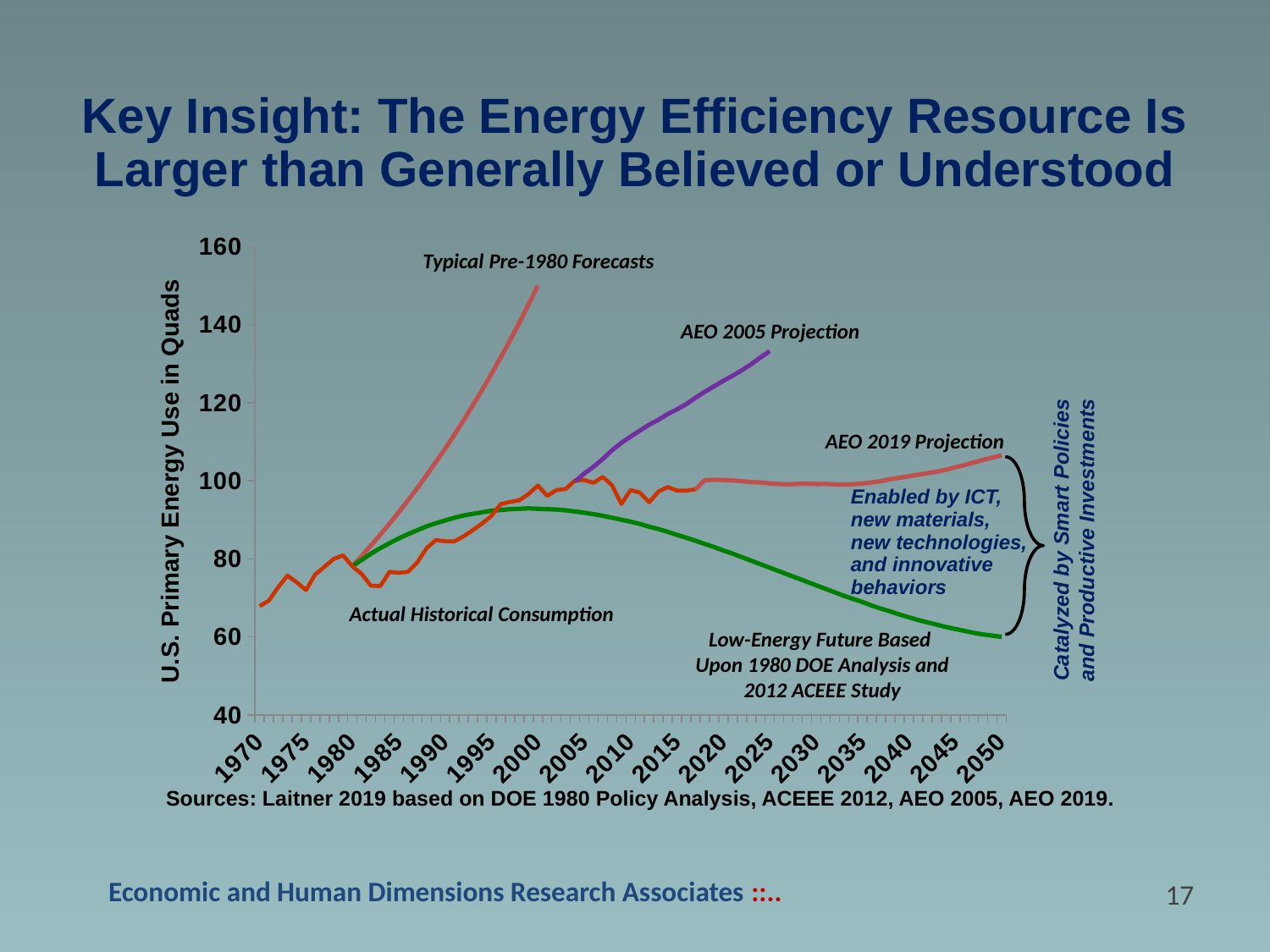
Is the value of the Typical Pre-1980 Forecasts line at its end point (around 2000) greater or less than 140? greater What is the label of the vertical axis? U.S. Primary Energy Use in Quads Which line reaches the highest value on the chart? Typical Pre-1980 Forecasts Is the value of the AEO 2019 Projection line in 2050 greater or less than 100? greater Is the value of the Low-Energy Future line in 2050 greater or less than 80? less In 2050, which line is higher: the AEO 2019 Projection or the Low-Energy Future line? AEO 2019 Projection Does the Low-Energy Future line rise or fall between 2000 and 2050? fall Does the Typical Pre-1980 Forecasts line rise or fall from 1980 to 2000? rise What kind of chart is shown on the slide? line chart How many labelled lines (series) are plotted on the chart? 5